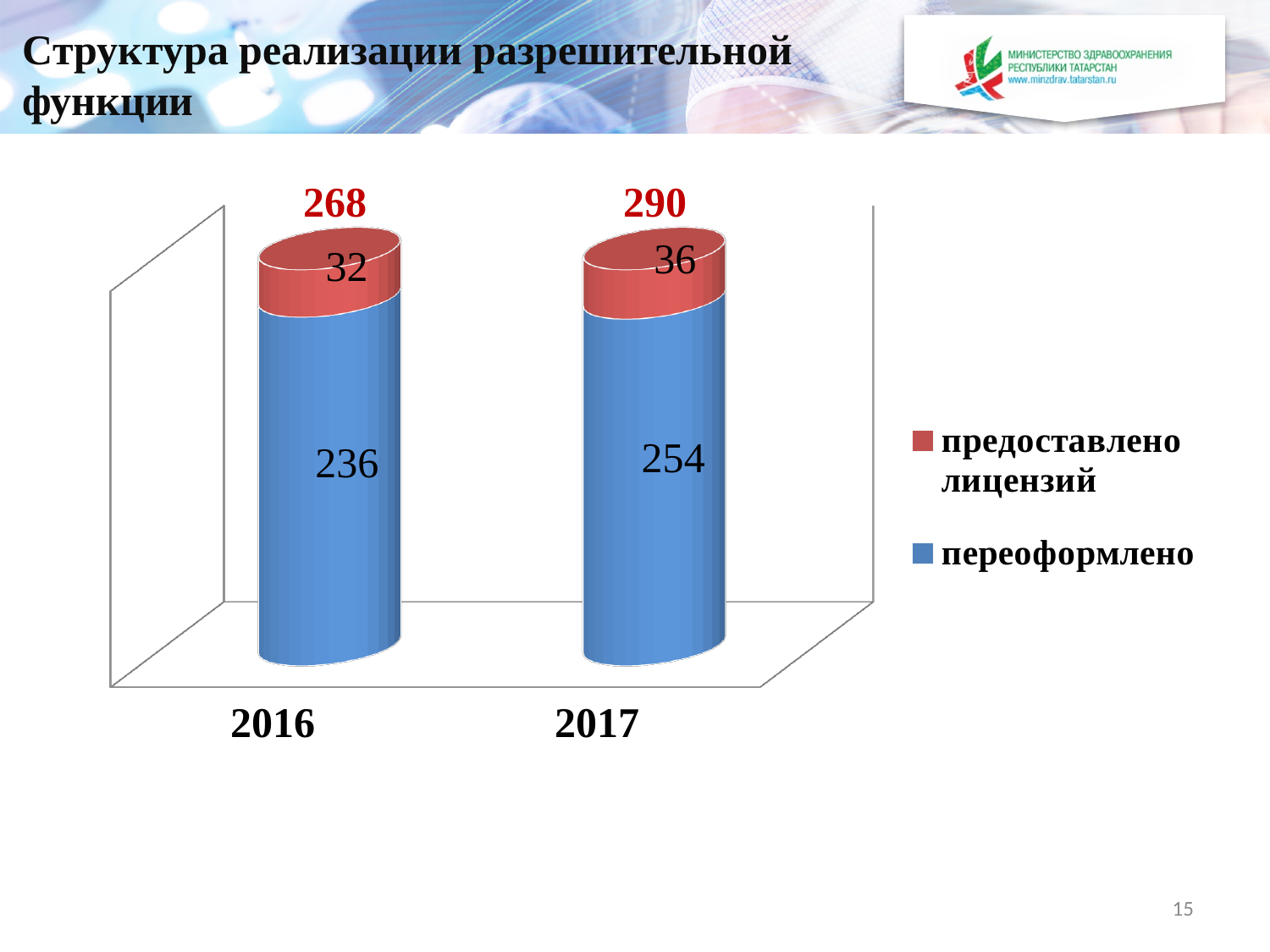
What is the value for "переоформлено" in 2016? 236 What is the value for "предоставлено лицензий" in 2016? 32 What kind of chart is shown on the slide? Stacked bar chart What is the total of the stacked bar for 2016? 268 How many categories are shown on the x axis? 2 What is the total of the stacked bar for 2017? 290 What is the value for "переоформлено" in 2017? 254 How many series does the legend list? 2 Is the "предоставлено лицензий" value larger in 2016 or 2017? 2017 What is the difference between the "переоформлено" values for 2017 and 2016? 18 What is the value for "предоставлено лицензий" in 2017? 36 Which year has the higher total? 2017